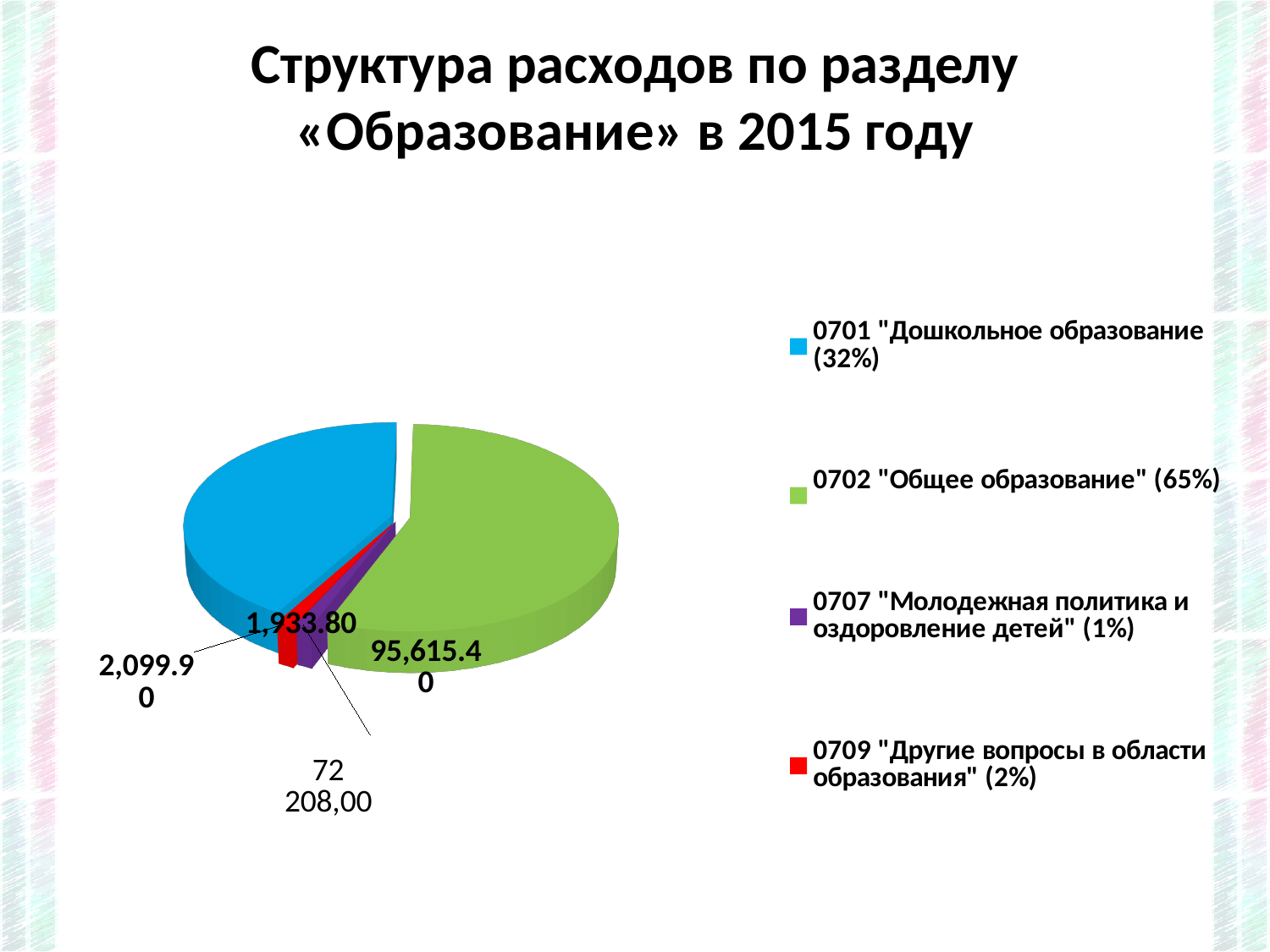
What kind of chart is shown on the slide? pie chart What share of the pie does 0709 "Другие вопросы в области образования" have? 2% What share of the pie does 0701 "Дошкольное образование" have? 32% How many slices does the pie chart have? 4 What share of the pie does 0707 "Молодежная политика и оздоровление детей" have? 1% Which category has the largest slice of the pie? 0702 "Общее образование" Which is larger, the share for 0701 "Дошкольное образование" or for 0709 "Другие вопросы в области образования"? 0701 "Дошкольное образование" What is the title of the slide? Структура расходов по разделу «Образование» в 2015 году Which category has the smallest slice of the pie? 0707 "Молодежная политика и оздоровление детей" What is the value labelled on the 0702 "Общее образование" slice? 95,615.40 What colour is the slice for 0702 "Общее образование"? green